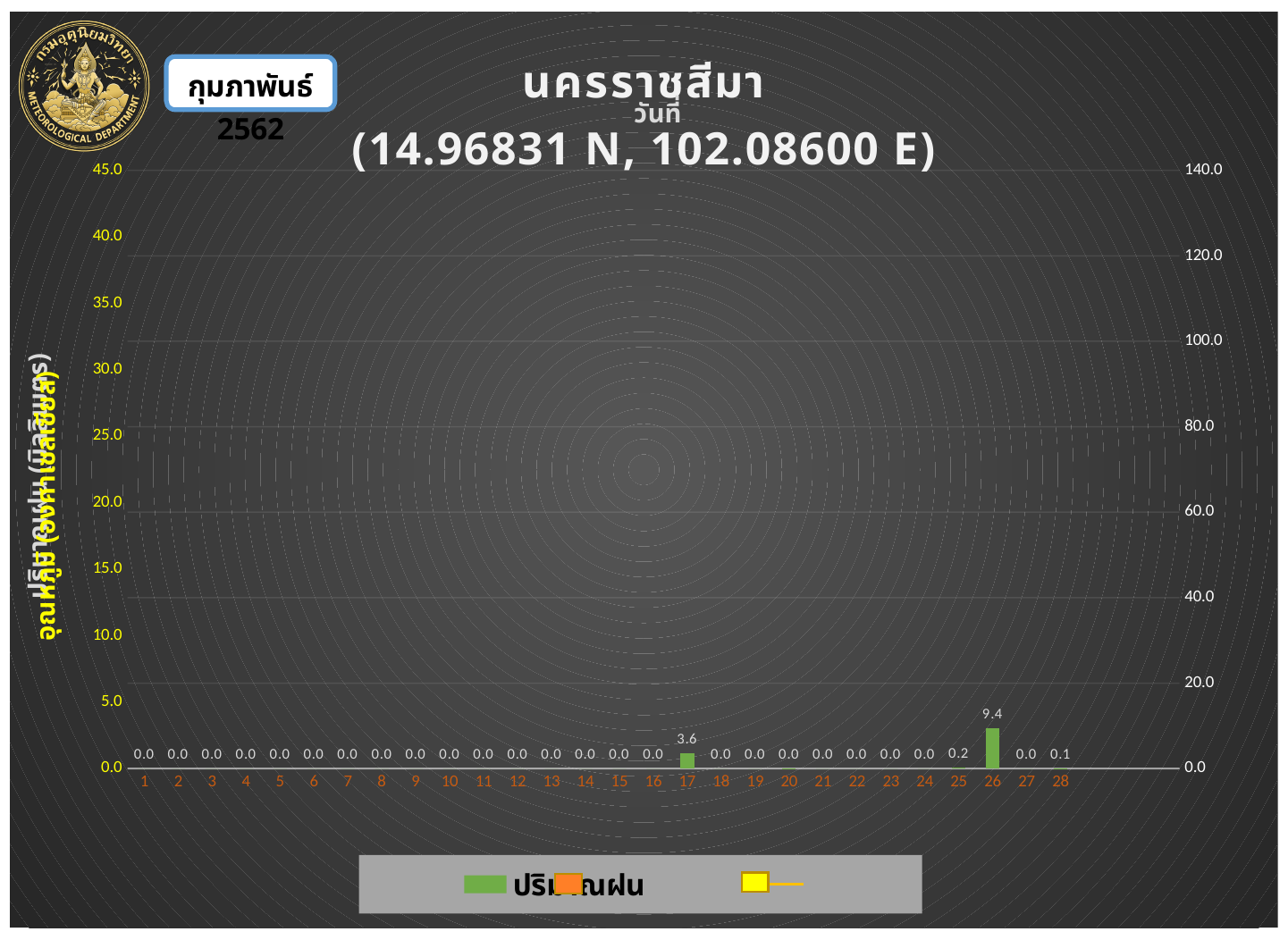
What is the value for day 17? 3.6 What is the difference between the values for day 26 and day 17? 5.8 How many days are shown on the x axis? 28 What is the highest tick value shown on the left vertical axis? 45.0 What is the value for day 26? 9.4 What is the value for day 10? 0.0 Which is larger, the value for day 17 or the value for day 25? day 17 What is the value for day 28? 0.1 What kind of chart is this? bar chart Which day has the highest value? 26 Is the value for day 26 greater or less than 10.0? less What is the value for day 25? 0.2